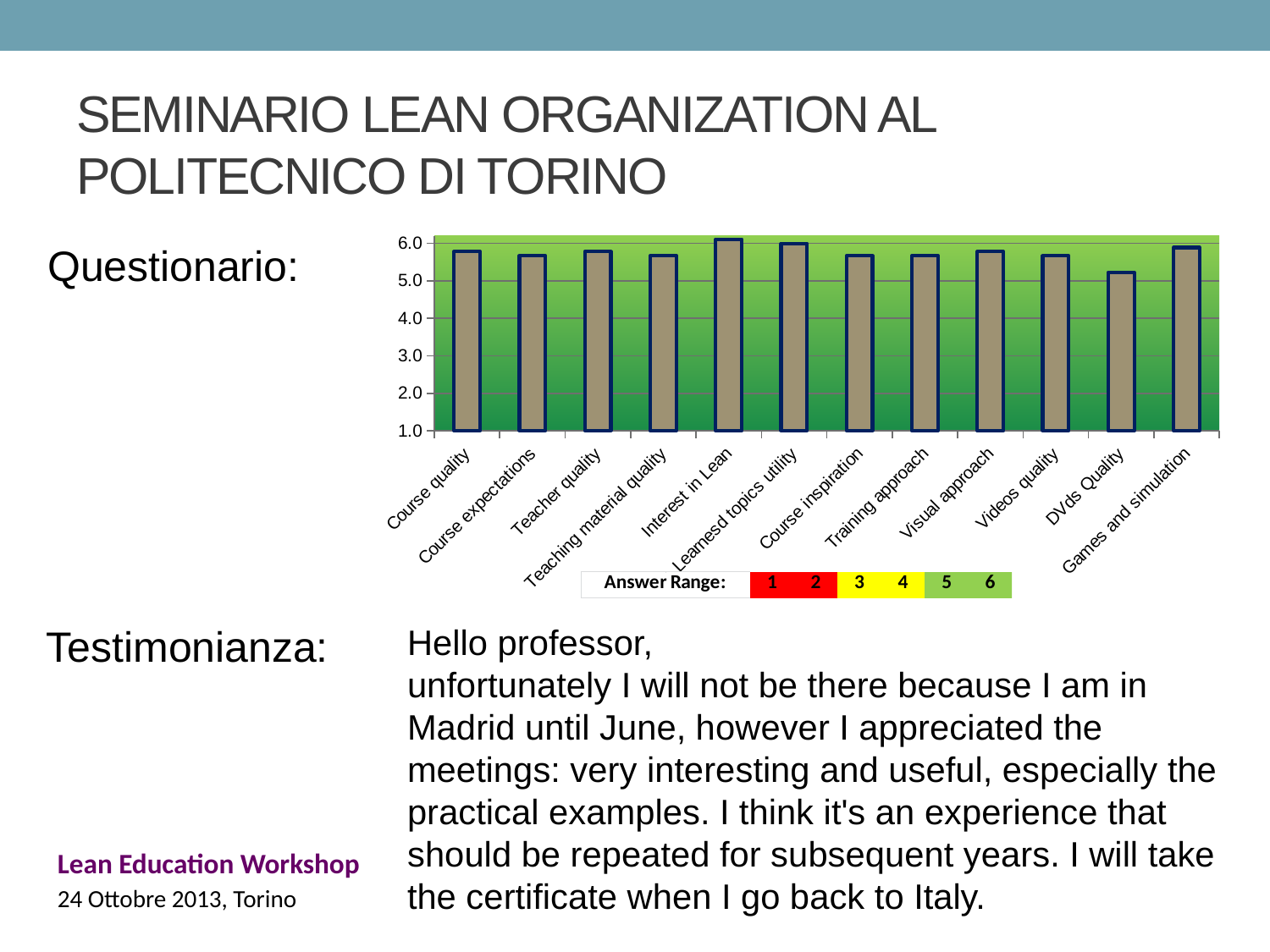
Which is larger, the value for Interest in Lean or the value for DVds Quality? Interest in Lean Is the value for Interest in Lean greater or less than 5.0? greater Is the value for Course quality greater or less than 5.0? greater Is the value for Videos quality greater or less than 4.0? greater How many categories are plotted in the questionnaire bar chart? 12 Which is larger, the value for Games and simulation or the value for DVds Quality? Games and simulation What kind of chart is shown under "Questionario"? bar chart What is the lowest value shown on the y axis of the questionnaire chart? 1.0 What is the highest value shown on the y axis of the questionnaire chart? 6.0 Which category has the lowest bar in the questionnaire chart? DVds Quality